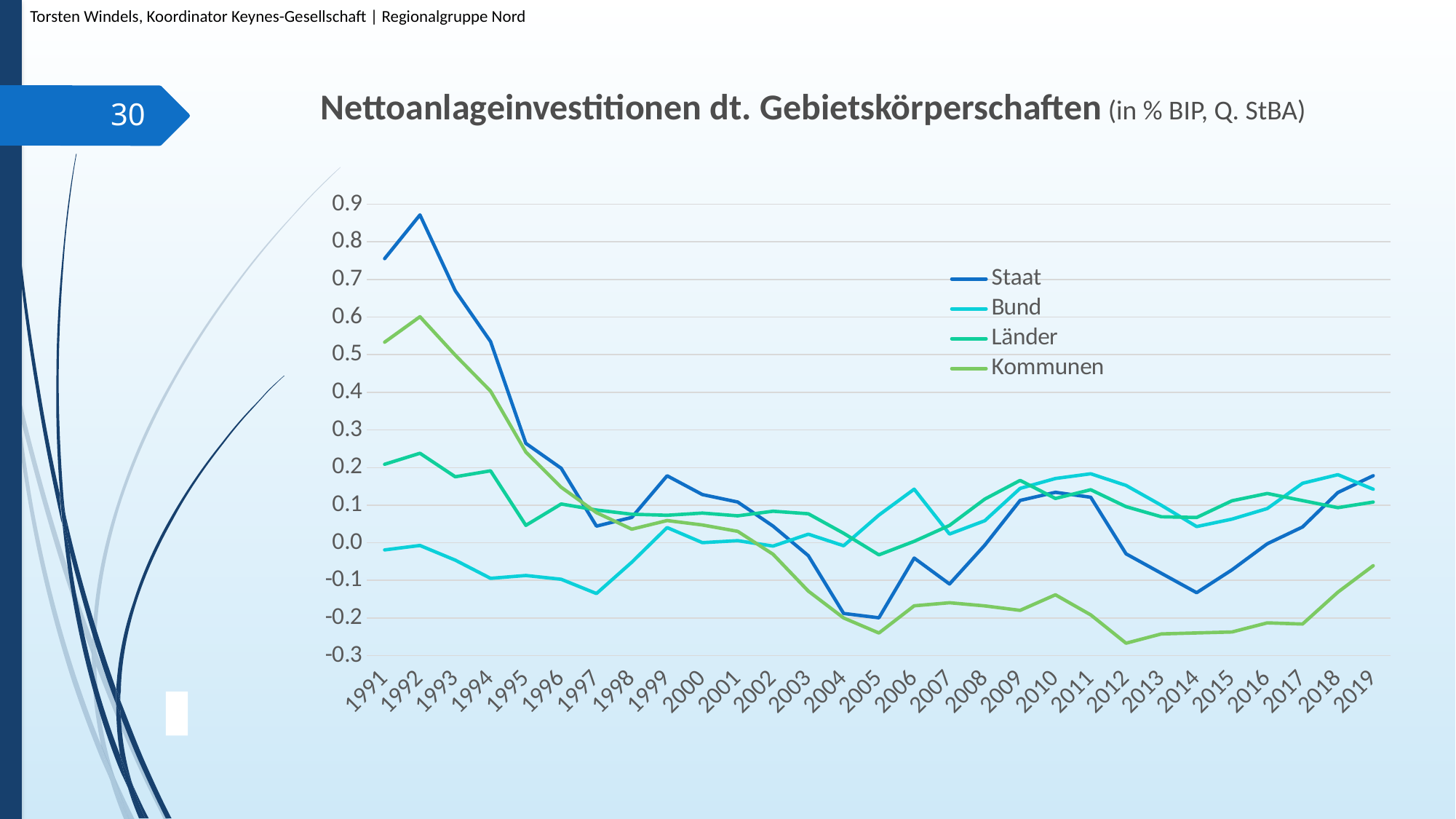
How many years are plotted along the x axis? 29 How many series does the legend list? 4 Is the value for Kommunen in 2012 greater or less than -0.2? less Does the Staat line rise or fall between 1992 and 1997? fall In which year does the Kommunen line reach its lowest value? 2012 Which series has the larger value in 2019, Bund or Kommunen? Bund What kind of chart is shown on the slide? line chart Is the value for Staat in 1992 greater or less than 0.8? greater What is the title of the chart? Nettoanlageinvestitionen dt. Gebietskörperschaften (in % BIP, Q. StBA) Which series has the larger value in 1991, Staat or Kommunen? Staat Is the value for Bund in 1997 greater or less than -0.1? less In which year does the Staat line reach its highest value? 1992